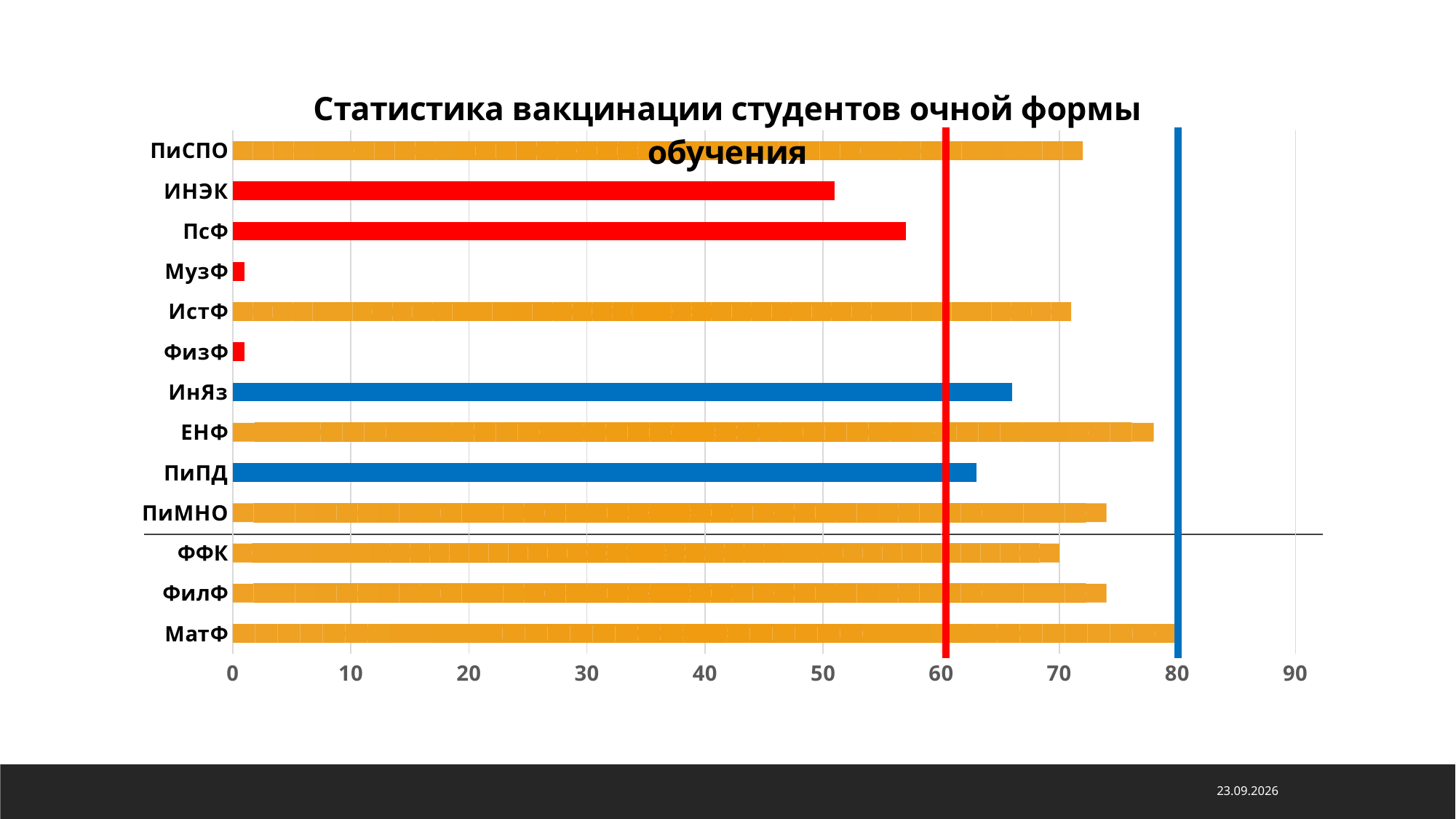
Is the value for ПиМНО greater or less than 70? greater How many categories (faculties) are plotted in the chart? 13 What is the value for МатФ? 80 Which is larger, the value for ЕНФ or the value for ИнЯз? ЕНФ Which is larger, the value for ПсФ or the value for ИНЭК? ПсФ Is the value for ЕНФ greater or less than 70? greater Is the value for ИНЭК greater or less than 60? less Which category has the highest value in the chart? МатФ What kind of chart is shown on the slide? bar chart What is the title of the chart? Статистика вакцинации студентов очной формы обучения